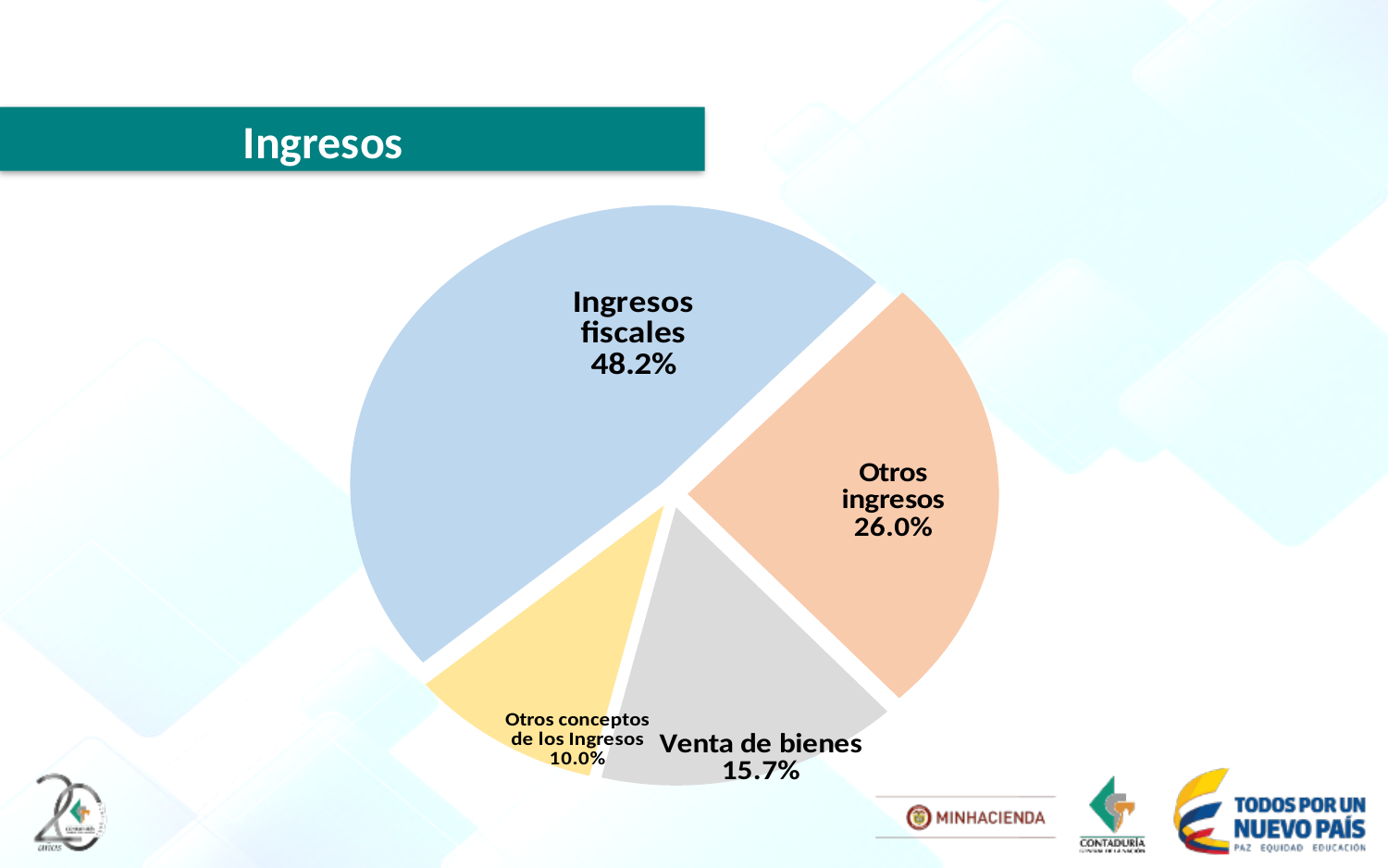
What colour is the Ingresos fiscales slice? light blue What is the value shown for Otros conceptos de los Ingresos? 10.0% What is the title shown above the chart? Ingresos What share of the pie does Ingresos fiscales represent? 48.2% Which slice of the pie is the largest? Ingresos fiscales What is the value shown for Otros ingresos? 26.0% What is the value shown for Venta de bienes? 15.7% Which slice of the pie is the smallest? Otros conceptos de los Ingresos Which is larger, Venta de bienes or Otros conceptos de los Ingresos? Venta de bienes How many slices does the pie chart have? 4 What is the difference in percentage points between Ingresos fiscales and Otros ingresos? 22.2 What kind of chart is shown on the slide? pie chart